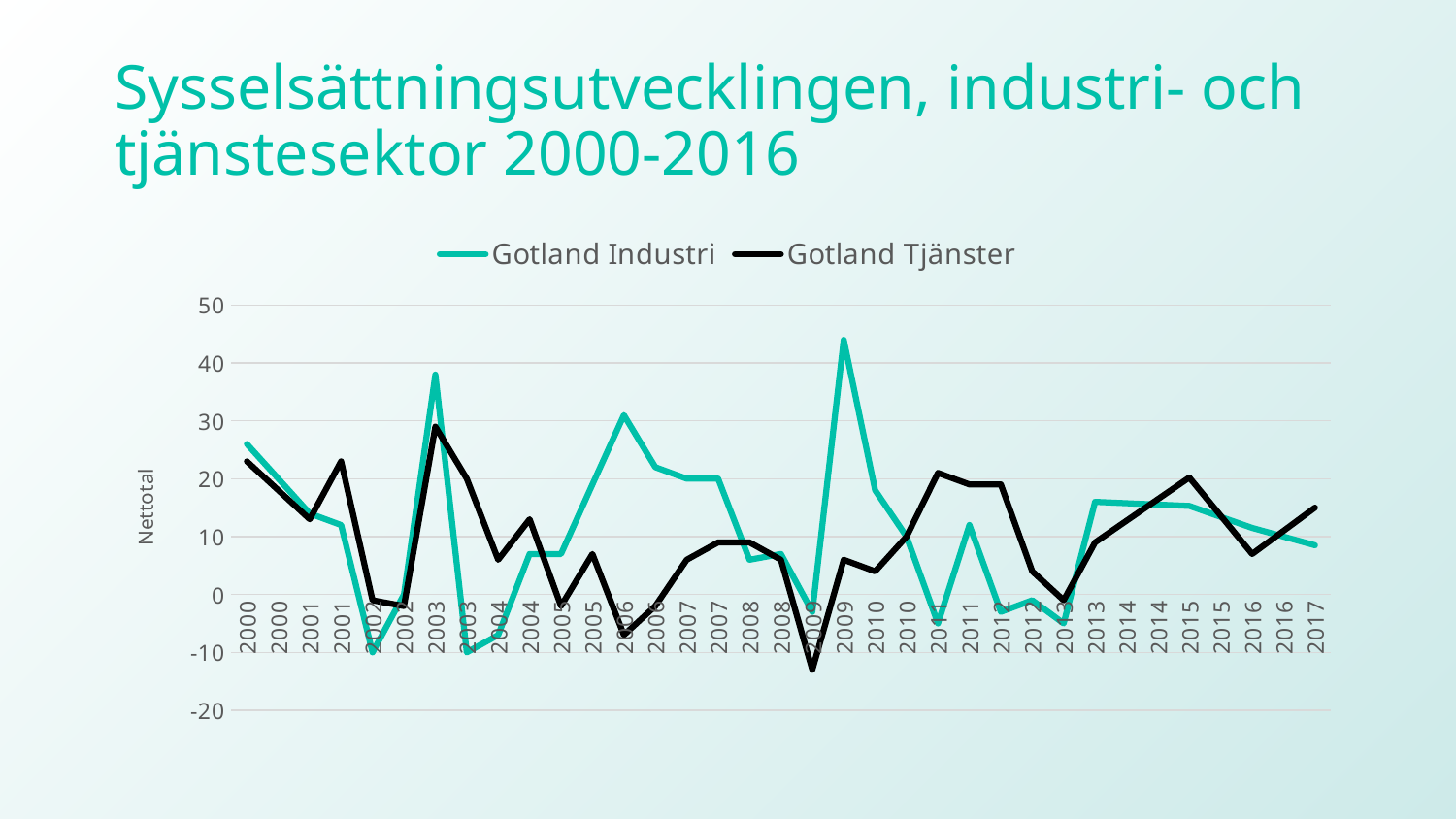
How many series does the legend list? 2 Is the value for Gotland Industri at the first 2003 point greater or less than 30? greater What are the two series named in the legend? Gotland Industri and Gotland Tjänster What kind of chart is shown on the slide? line chart Does the Gotland Industri line rise or fall from 2014 to 2017? fall What is the label on the vertical axis? Nettotal At the first 2009 point, which series has the larger value, Gotland Industri or Gotland Tjänster? Gotland Industri Is the lowest value of Gotland Tjänster, in 2009, greater or less than -10? less Is the peak value of Gotland Industri in 2009 greater or less than 40? greater At the first 2006 point, which series has the larger value, Gotland Industri or Gotland Tjänster? Gotland Industri Which series reaches the highest value on the chart? Gotland Industri